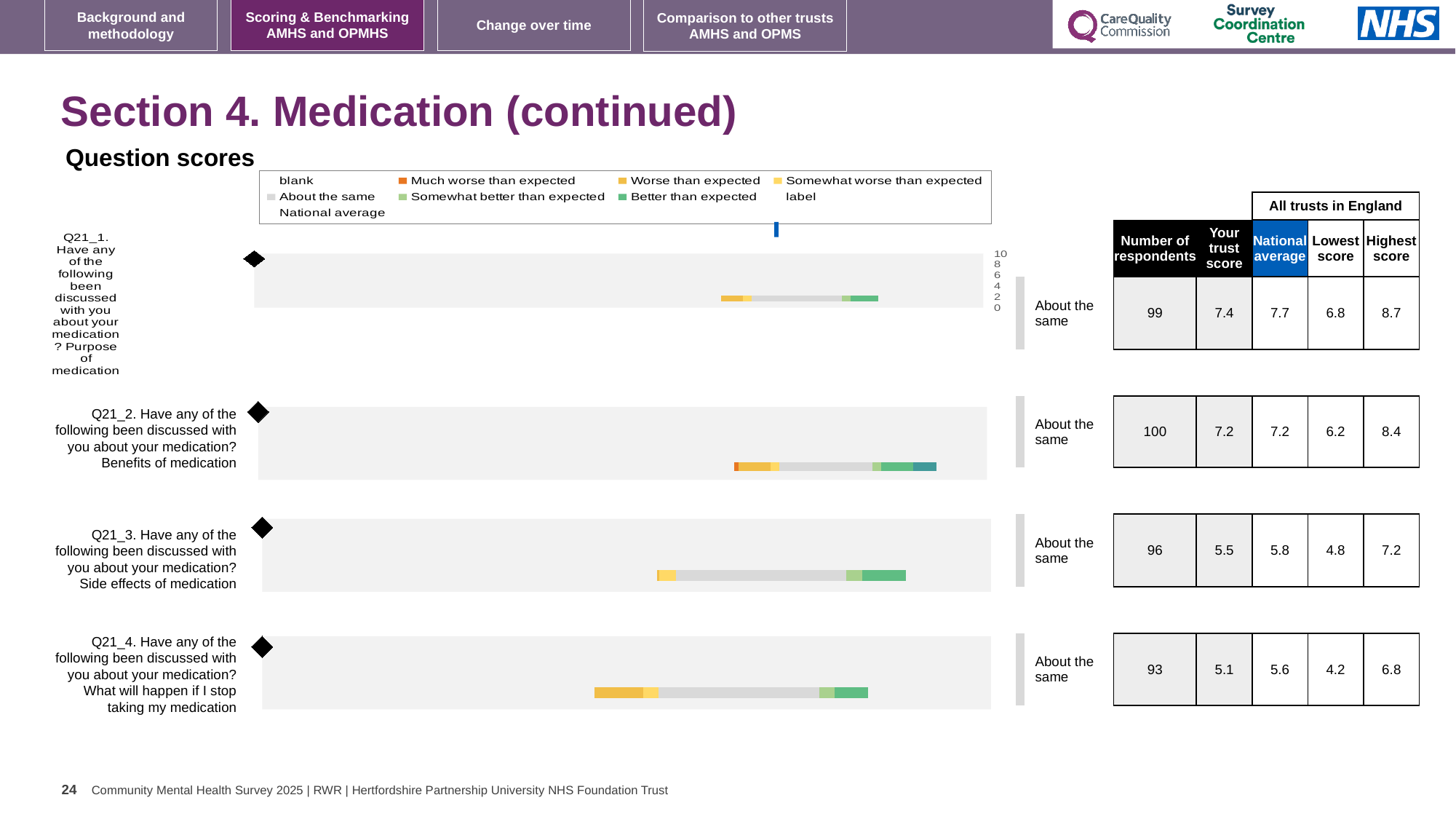
For the Q21_4 chart, what is the difference between the Highest score and the Lowest score? 2.6 For the Q21_1 chart, which is larger: Your trust score or the National average? National average For the Q21_4 chart (What will happen if I stop taking my medication), what is the Lowest score shown? 4.2 How many entries does the legend above the charts list? 9 How many question charts (Q21_1 to Q21_4) are shown on the slide? 4 Which of the four questions has the lowest number of respondents? Q21_4 What kind of chart is used for each question score on the slide? Bar chart For the Q21_1 chart (Purpose of medication), what is the 'Your trust score' shown in the table? 7.4 Which of the four questions has the highest 'Your trust score'? Q21_1 What benchmark category label is shown to the right of each of the four charts? About the same For the Q21_3 chart (Side effects of medication), how many respondents are shown? 96 For the Q21_2 chart (Benefits of medication), what is the National average shown? 7.2